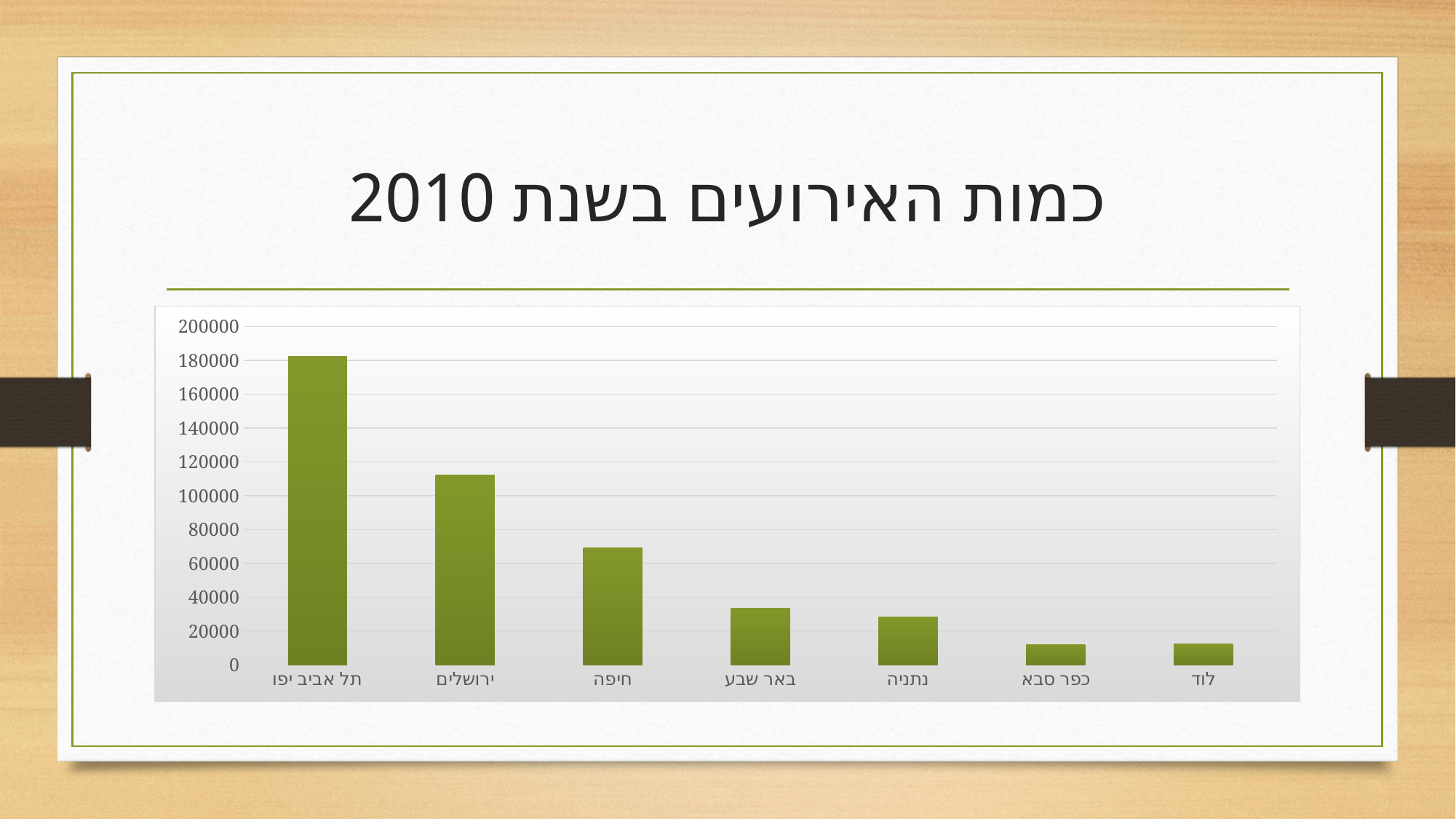
How many cities are shown on the x axis of the chart? 7 Which city has the highest number of events in the chart? תל אביב יפו Which has a larger value, ירושלים or חיפה? ירושלים Is the value for חיפה greater or less than 80000? less Is the value for נתניה greater or less than 20000? greater Is the value for באר שבע greater or less than 40000? less Do the values rise or fall moving from תל אביב יפו to לוד along the x axis? fall What kind of chart is shown on the slide? bar chart What is the title of the slide? כמות האירועים בשנת 2010